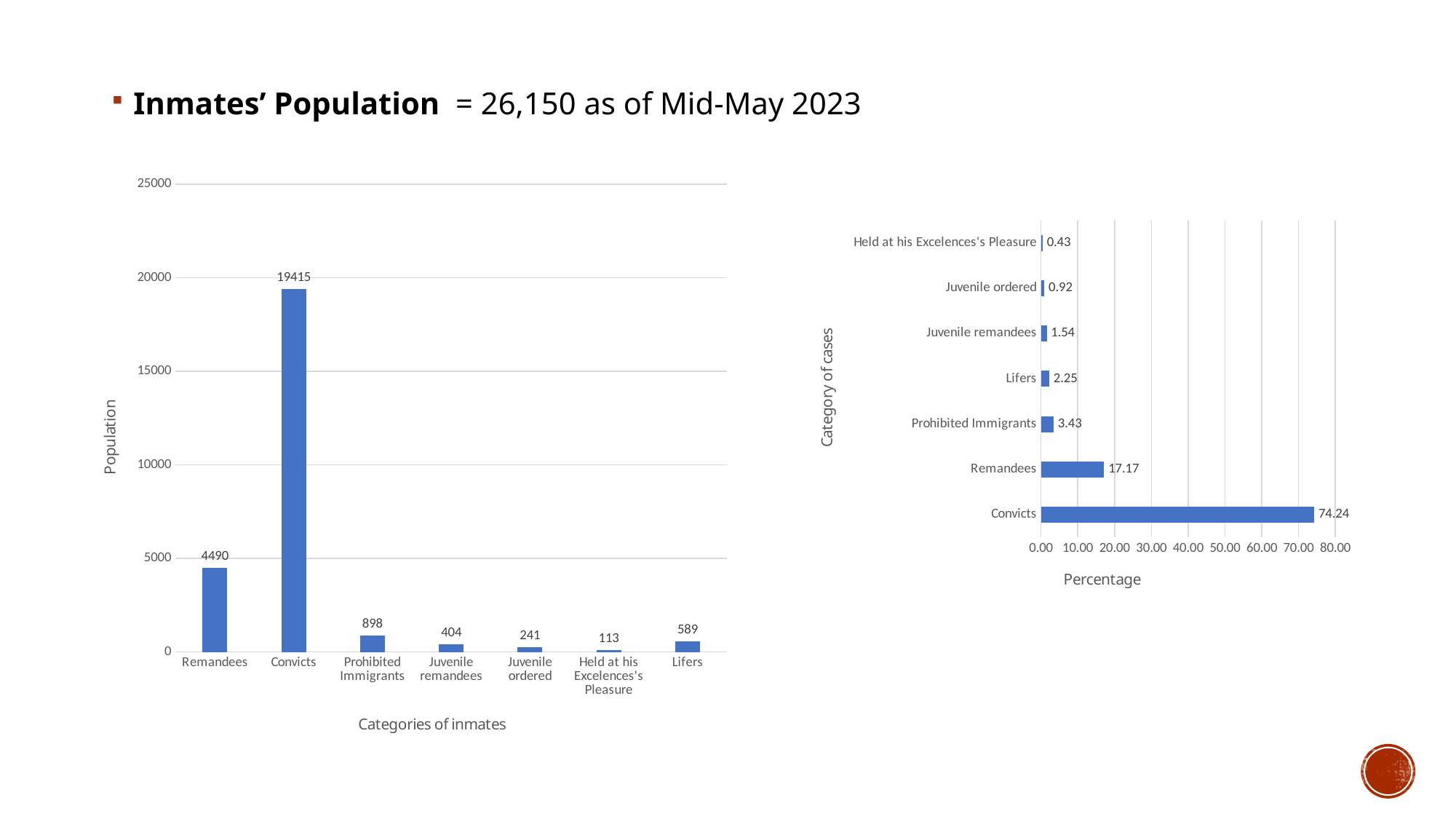
In the left chart (Population by categories of inmates), which is larger, Juvenile remandees or Juvenile ordered? Juvenile remandees What kind of chart is the left chart (Population by categories of inmates)? Bar chart What is the x-axis title of the right chart? Percentage In the left chart (Population by categories of inmates), what is the value for Convicts? 19415 In the right chart (Percentage by category of cases), what is the value for Remandees? 17.17 In the left chart (Population by categories of inmates), how many categories are shown? 7 In the right chart (Percentage by category of cases), which category has the highest percentage? Convicts In the left chart (Population by categories of inmates), what is the difference between Prohibited Immigrants and Lifers? 309 In the left chart (Population by categories of inmates), what is the value for Remandees? 4490 In the right chart (Percentage by category of cases), what is the difference between Prohibited Immigrants and Juvenile remandees? 1.89 In the left chart (Population by categories of inmates), which category has the lowest population? Held at his Excelences's Pleasure In the right chart (Percentage by category of cases), what is the value for Lifers? 2.25